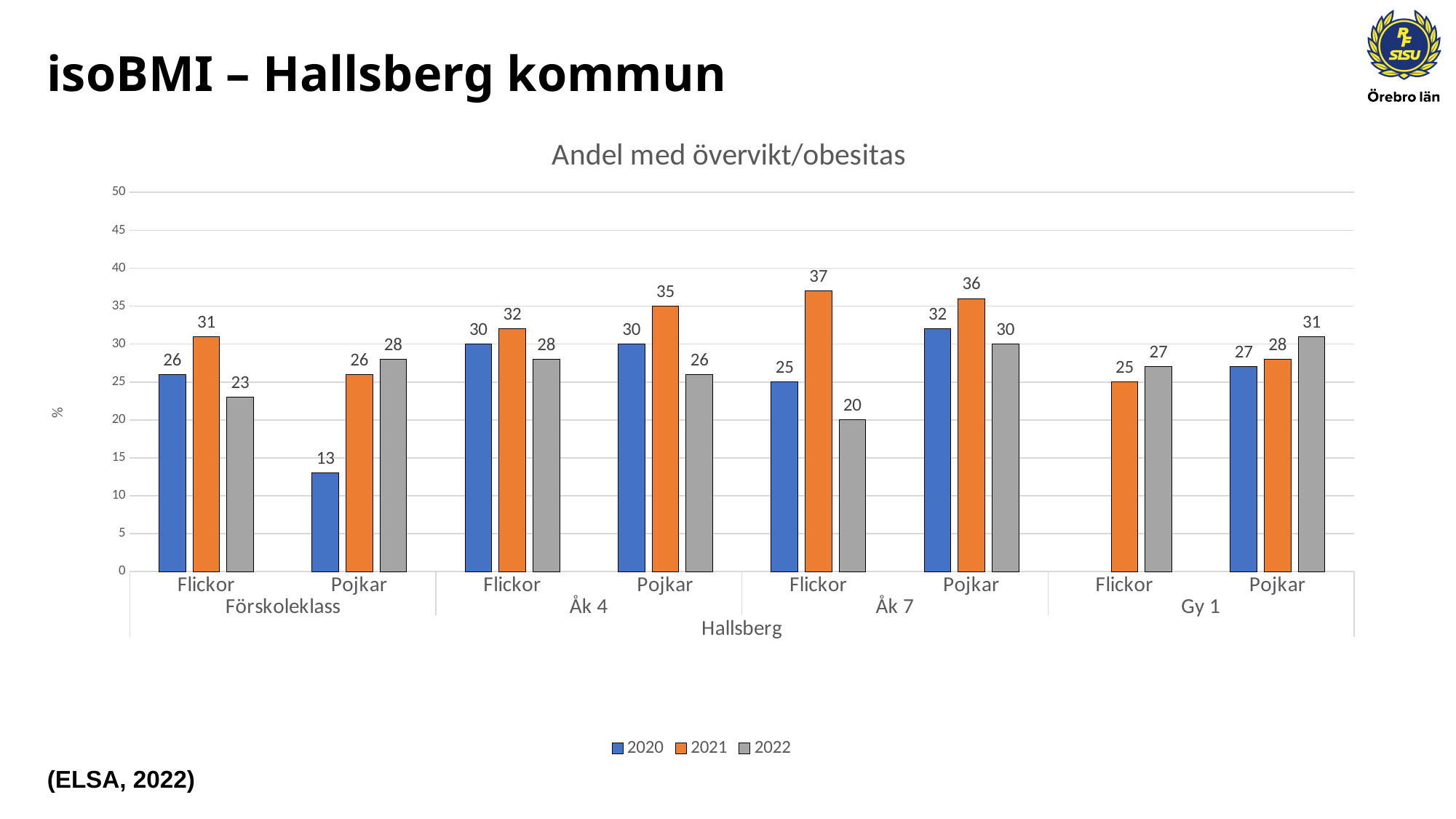
Which group has the lowest 2020 value? Pojkar, Förskoleklass Which series is shown in orange in the legend? 2021 What kind of chart is shown on the slide? Bar chart What is the difference between the 2021 and 2022 values for Flickor in Åk 7? 17 Which group has the highest 2021 value? Flickor, Åk 7 Which is larger for Pojkar in Åk 4: the 2021 value or the 2022 value? 2021 What is the 2020 value for Pojkar in Förskoleklass? 13 How many series does the legend list? 3 What is the 2021 value for Flickor in Åk 7? 37 What is the 2022 value for Pojkar in Gy 1? 31 What is the title of the chart? Andel med övervikt/obesitas What is the 2022 value for Flickor in Förskoleklass? 23